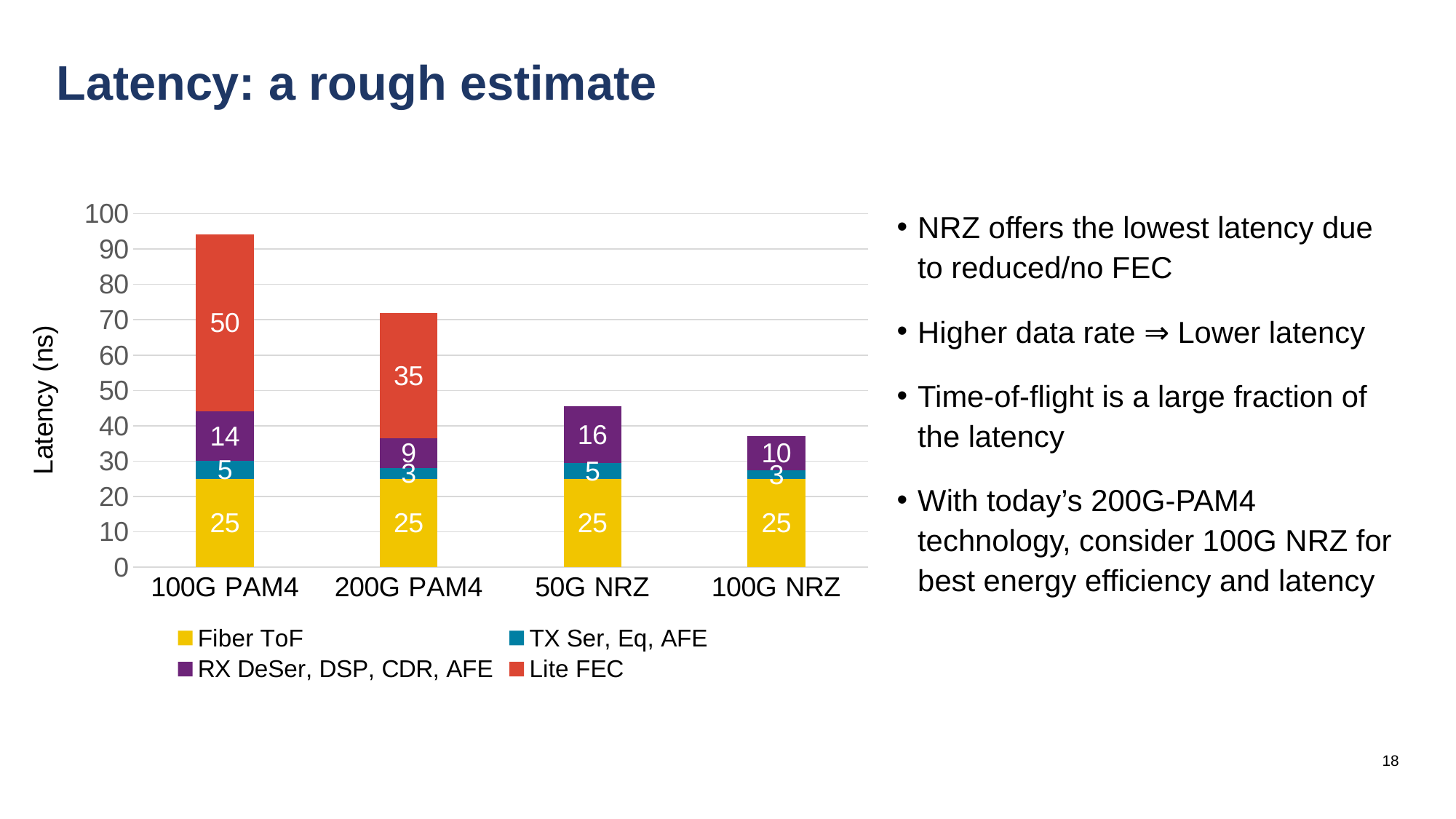
How many categories are shown on the x axis? 4 What is the TX Ser, Eq, AFE value for 200G PAM4? 3 How many series does the legend list? 4 What is the difference between the Lite FEC values for 100G PAM4 and 200G PAM4? 15 What is the RX DeSer, DSP, CDR, AFE value for 50G NRZ? 16 Which category has the highest total latency? 100G PAM4 What is the label of the y axis? Latency (ns) What is the Lite FEC value for 100G PAM4? 50 What is the total latency of the 100G PAM4 stacked bar? 94 Is the total latency for 50G NRZ greater or less than 50? less Which category has the lowest total latency? 100G NRZ What kind of chart is shown on the slide? Stacked bar chart